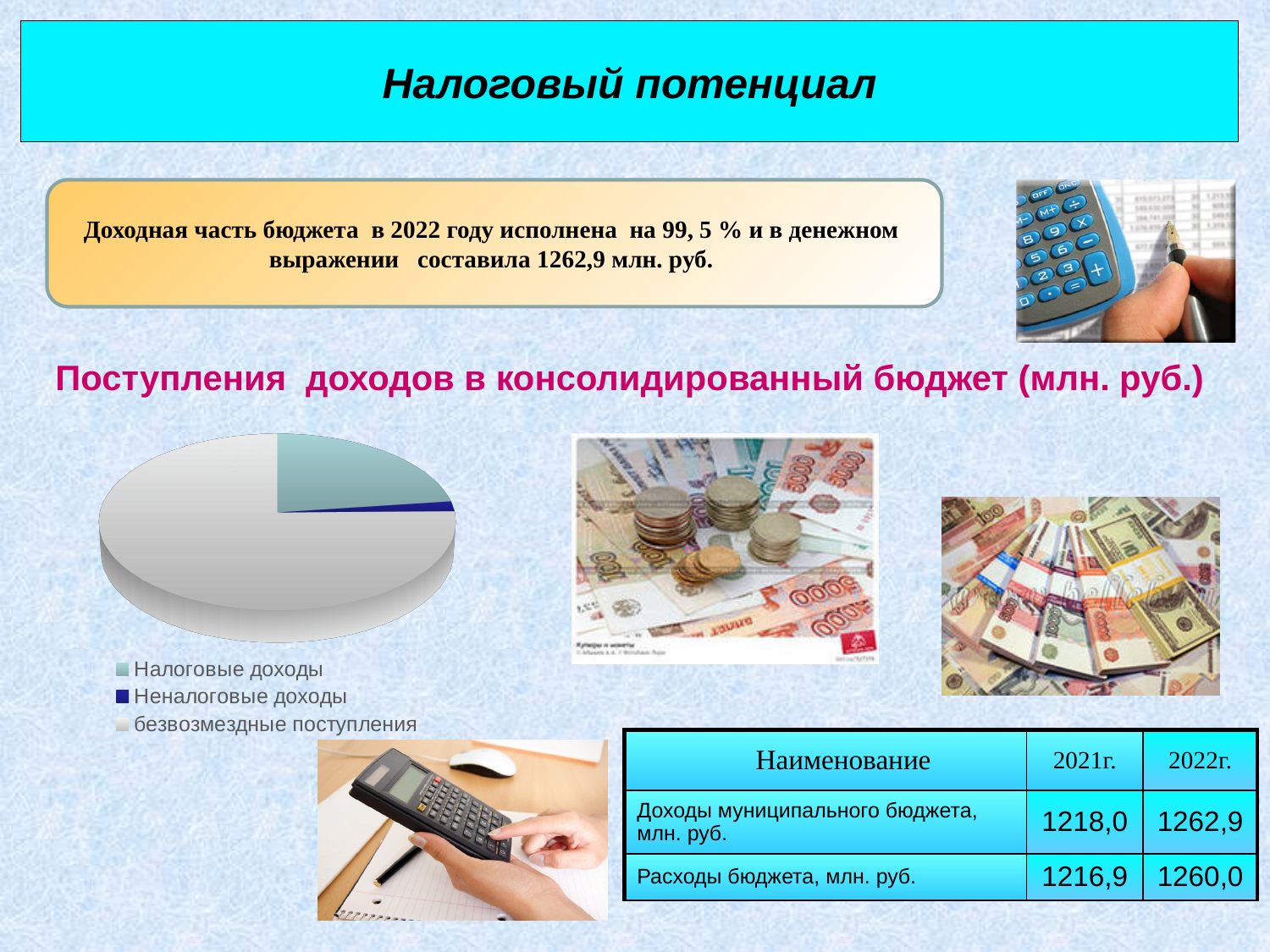
Which slice is larger in the pie chart: безвозмездные поступления or Налоговые доходы? безвозмездные поступления What is the title shown above the pie chart? Поступления доходов в консолидированный бюджет (млн. руб.) Which category has the largest slice in the pie chart? безвозмездные поступления Which category has the smallest slice in the pie chart? Неналоговые доходы Which slice is larger in the pie chart: Налоговые доходы or Неналоговые доходы? Налоговые доходы How many categories does the legend of the pie chart list? 3 Which legend entry of the pie chart is shown in dark blue? Неналоговые доходы What kind of chart is shown on the slide? pie chart